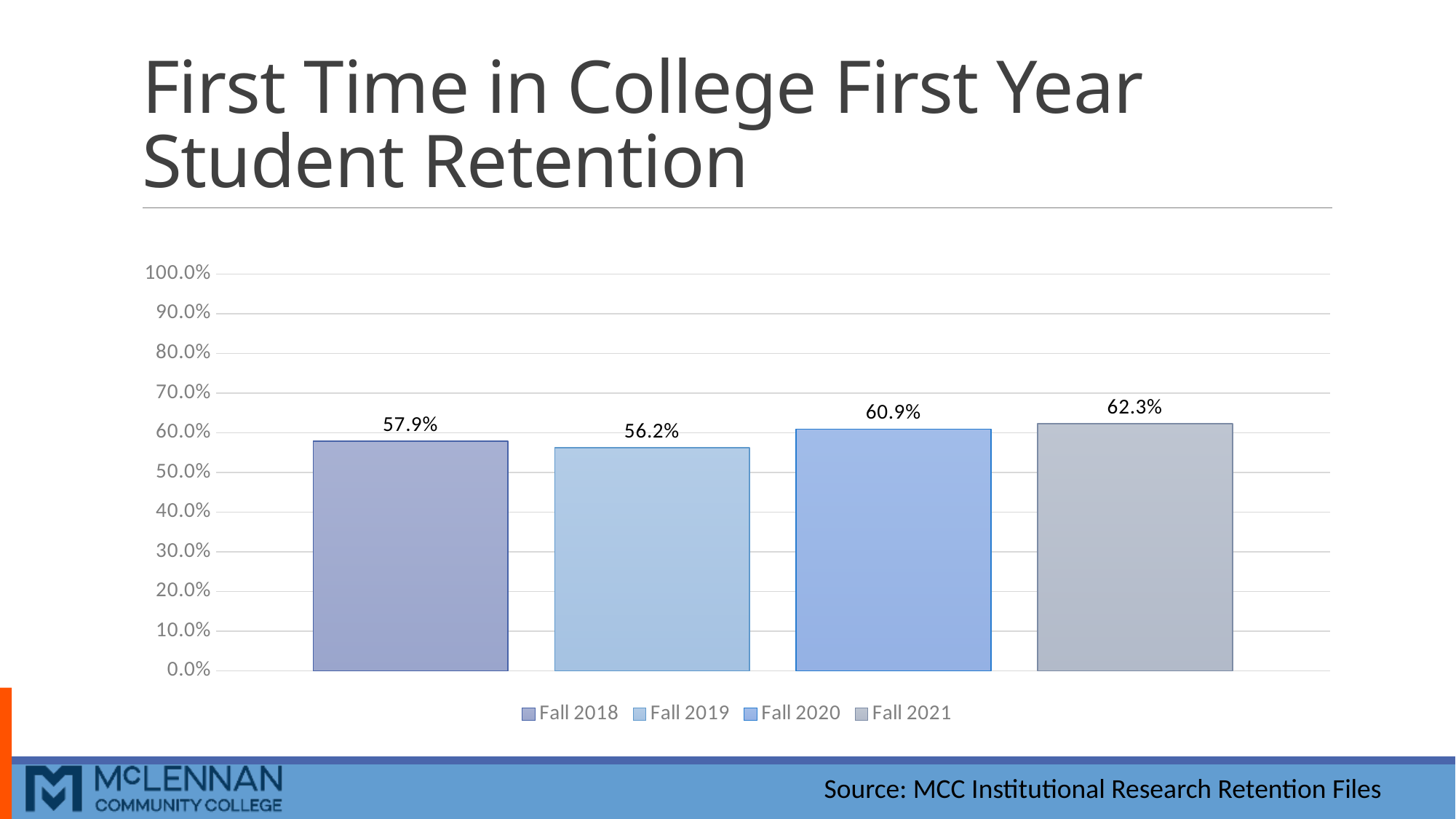
Which term has the lowest retention rate? Fall 2019 Which is larger, the retention rate for Fall 2020 or Fall 2019? Fall 2020 Which term has the highest retention rate? Fall 2021 What is the retention rate for Fall 2018? 57.9% What is the difference between the Fall 2021 and Fall 2018 retention rates? 4.4% What kind of chart is shown on the slide? Bar chart Is the value for Fall 2021 greater or less than 60.0%? greater What is the retention rate for Fall 2021? 62.3% How many terms are shown in the chart? 4 What is the retention rate for Fall 2020? 60.9% What is the retention rate for Fall 2019? 56.2% What is the source cited for the chart data? MCC Institutional Research Retention Files